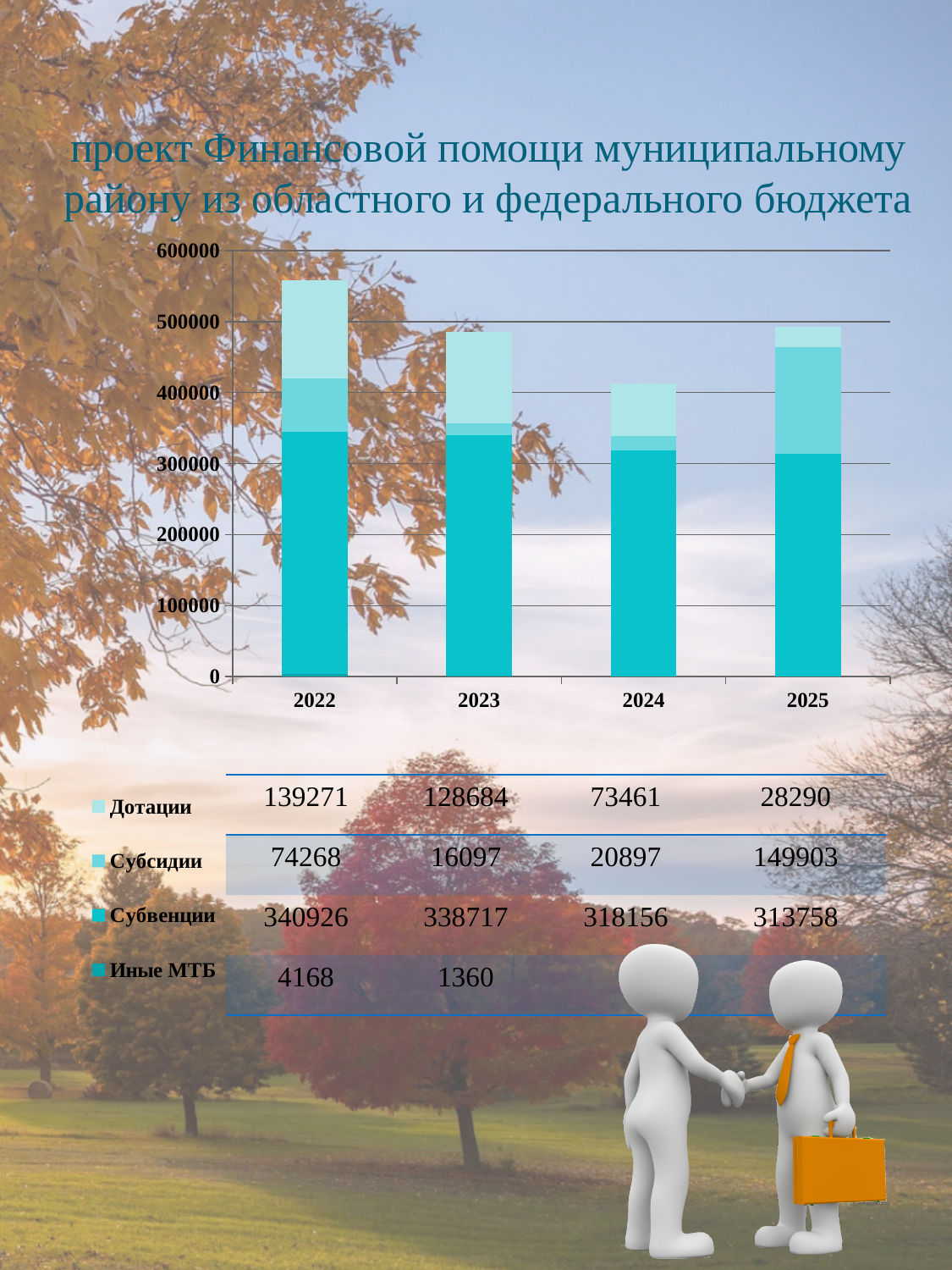
How many series does the legend list? 4 What is the value of Субсидии for 2024? 20897 In which year is the value of Дотации the lowest? 2025 What is the value of Дотации for 2025? 28290 Which is larger, Субвенции in 2024 or Субвенции in 2025? Субвенции in 2024 What is the value of Субвенции for 2022? 340926 What is the difference between the Дотации values for 2022 and 2023? 10587 What is the total of the stacked bar for 2024? 412514 What is the value of Иные МТБ for 2023? 1360 What kind of chart is shown on the slide? Stacked bar chart How many years are shown on the x axis? 4 In which year is the value of Субсидии the highest? 2025